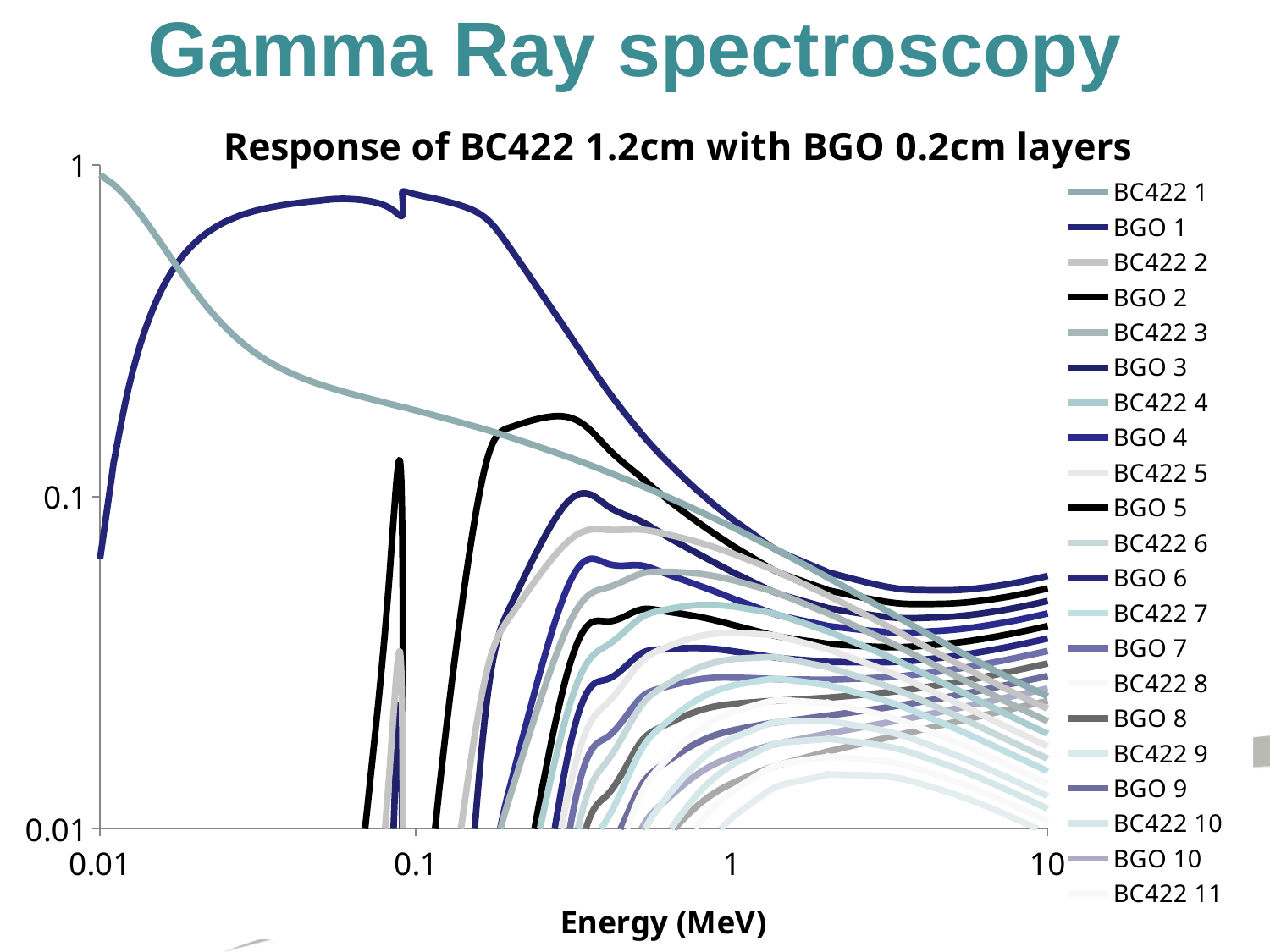
Is the peak value of the BGO 2 series greater or less than 0.1? greater At 0.01 MeV, which series has the larger value, BC422 1 or BGO 1? BC422 1 What kind of chart is shown on the slide? line chart Is the value of the BGO 1 series at 0.01 MeV greater or less than 0.1? less Does the BC422 1 series rise or fall as energy increases from 0.01 MeV to 10 MeV? fall What is the title of the chart? Response of BC422 1.2cm with BGO 0.2cm layers Is the value of the BC422 1 series at 0.01 MeV greater or less than 0.1? greater How many series does the chart's legend list? 21 How many tick labels are shown on the x axis? 4 At 0.1 MeV, which series has the larger value, BGO 1 or BC422 1? BGO 1 What is the label of the x axis? Energy (MeV)